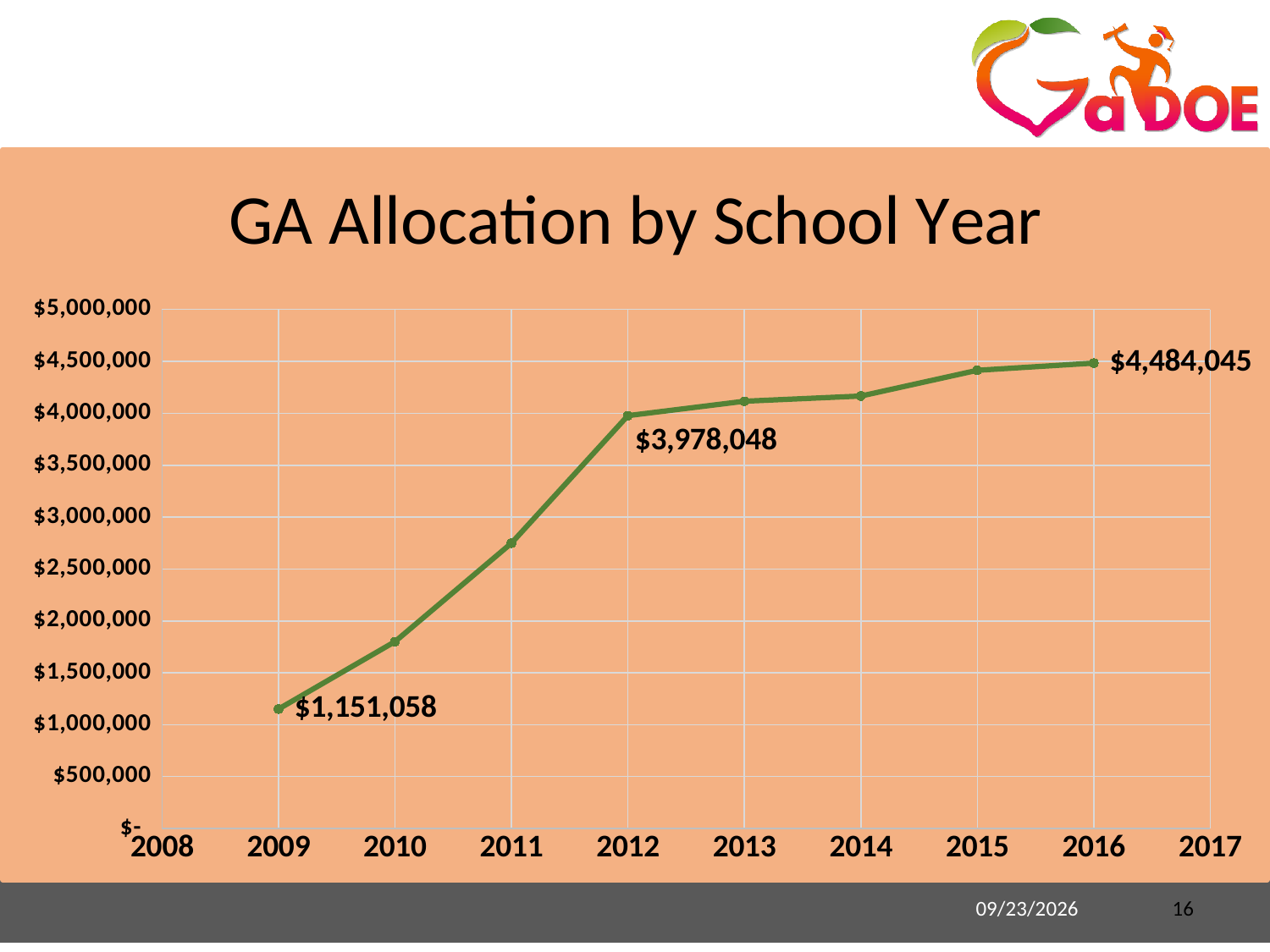
Which school year has the highest GA allocation? 2016 What is the difference between the 2012 and 2009 allocations? $2,826,990 Is the allocation for 2010 greater or less than $2,000,000? less Is the allocation for 2011 greater or less than $2,500,000? greater Which school year has the lowest GA allocation? 2009 What kind of chart is shown on the slide? line chart Which is larger, the allocation for 2011 or for 2012? 2012 How much larger is the 2016 allocation than the 2009 allocation? $3,332,987 What is the GA allocation for the 2012 school year? $3,978,048 How many school years have data points plotted on the chart? 8 What is the GA allocation for the 2009 school year? $1,151,058 What is the GA allocation for the 2016 school year? $4,484,045